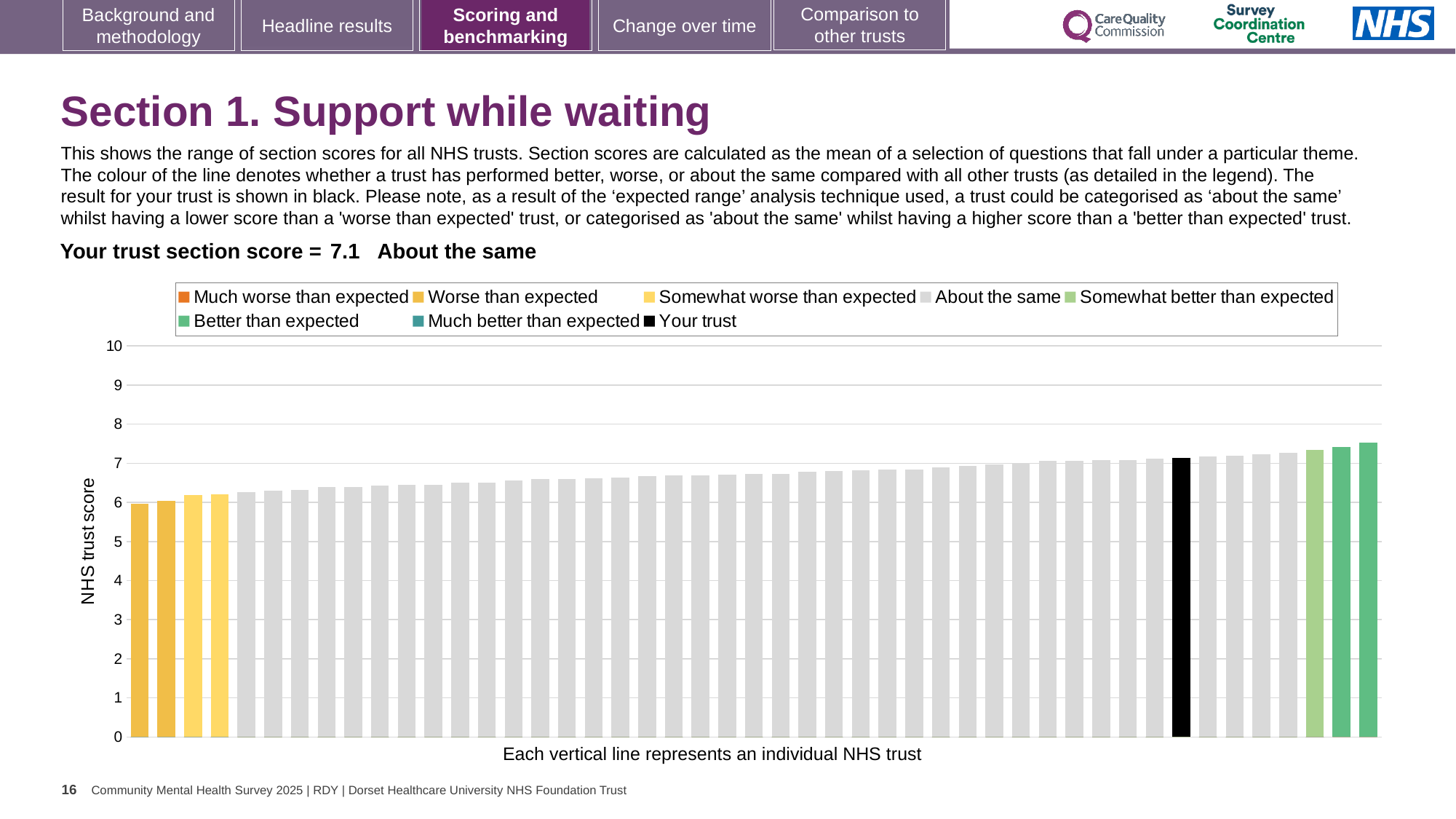
Is the value for the highest-scoring trust greater or less than 7? greater What is the label on the y axis of the chart? NHS trust score Do the trust scores rise or fall moving from left to right along the x axis? rise Which legend category does the lowest-scoring trust belong to? Worse than expected Is the value for the highest-scoring trust greater or less than 8? less Which performance category is your trust placed in for this section? About the same Is the value for the lowest-scoring trust greater or less than 7? less Which legend category does the highest-scoring trust belong to? Better than expected How many entries does the chart legend list? 8 What kind of chart is shown on the slide? bar chart What is the section score for your trust? 7.1 How many trusts are shown in the 'Better than expected' colour? 2